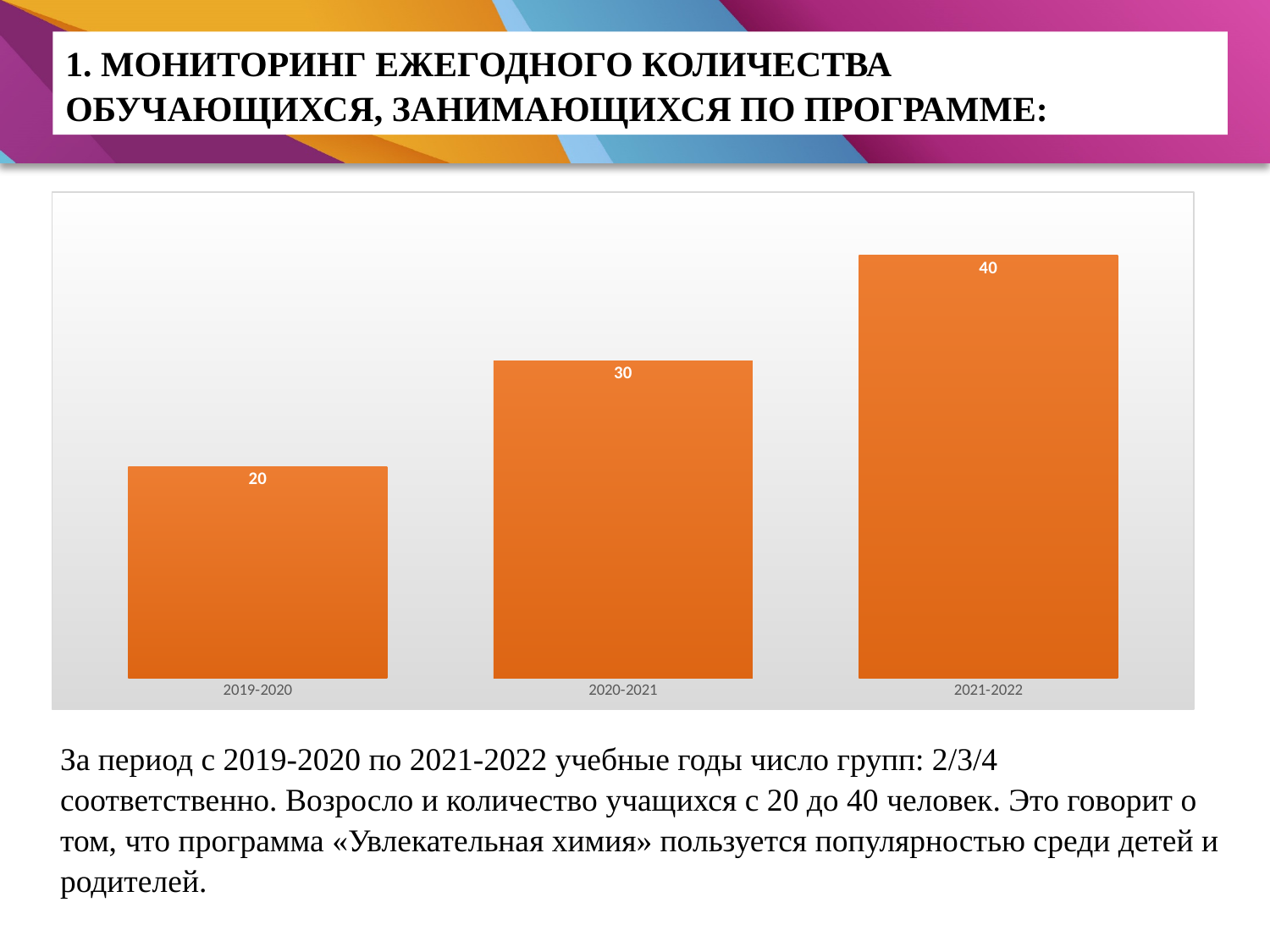
What is the value for 2019-2020? 20 What is the difference between the values for 2020-2021 and 2019-2020? 10 Which is larger, the value for 2020-2021 or the value for 2021-2022? 2021-2022 What kind of chart is shown on the slide? Bar chart Do the values rise or fall from 2019-2020 to 2021-2022? Rise What is the difference between the values for 2021-2022 and 2019-2020? 20 How many academic years are shown in the chart? 3 Which academic year has the lowest value? 2019-2020 What colour are the bars in the chart? Orange What is the value for 2021-2022? 40 What is the value for 2020-2021? 30 Which academic year has the highest value? 2021-2022